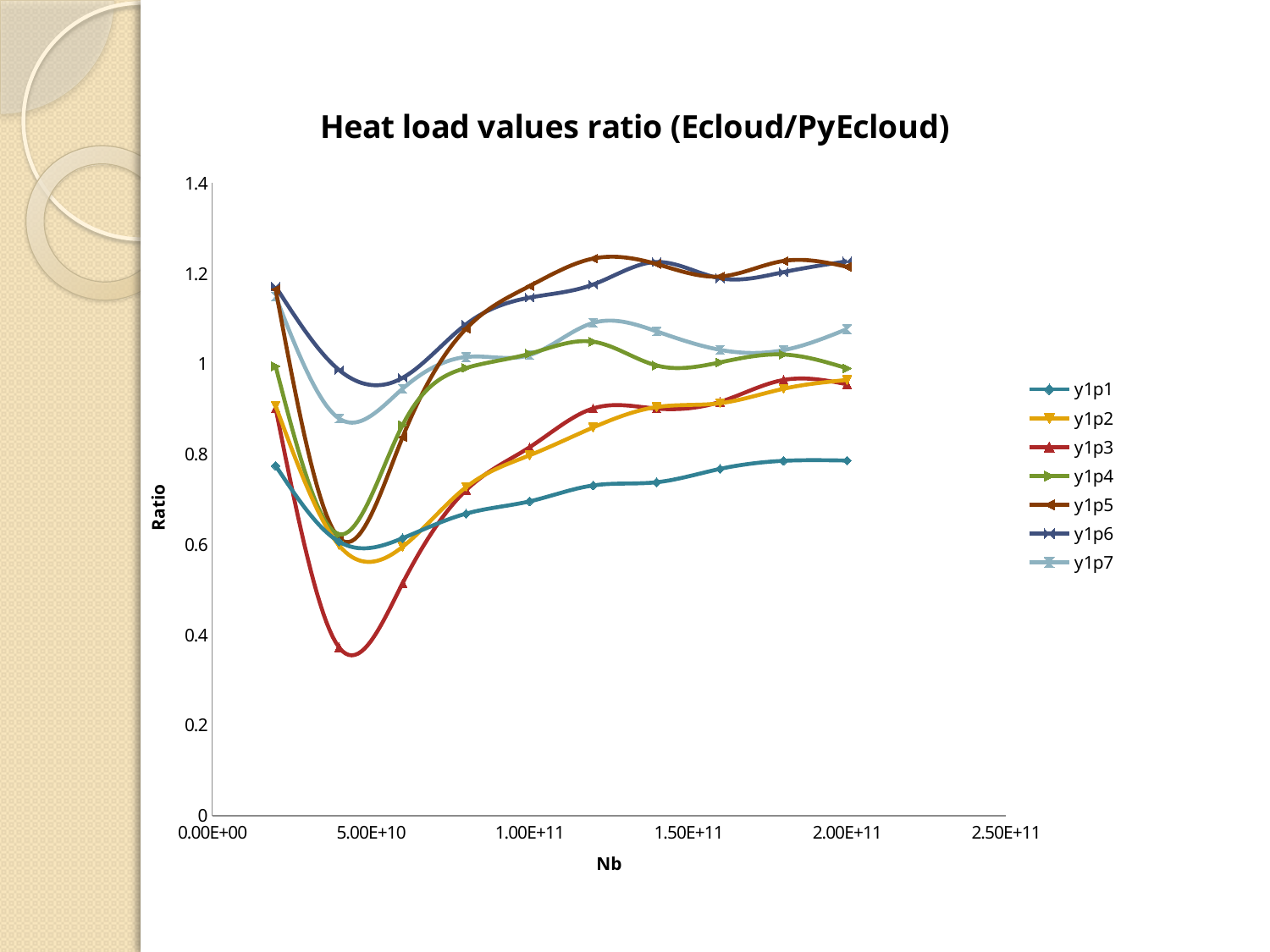
Which series has the highest value at Nb = 1.20E+11? y1p5 Which series has the lowest value at Nb = 2.00E+11? y1p1 Which series reaches the lowest value anywhere on the chart? y1p3 Is the value of y1p5 at Nb = 1.20E+11 greater or less than 1.2? greater What kind of chart is shown on the slide? line chart What is the title of the chart? Heat load values ratio (Ecloud/PyEcloud) Does the y1p1 series rise or fall between Nb = 6.00E+10 and Nb = 2.00E+11? rise What is the label of the vertical axis? Ratio At Nb = 2.00E+11, which series has the larger value, y1p1 or y1p3? y1p3 Is the value of y1p1 at Nb = 2.00E+11 greater or less than 1? less How many series does the legend list? 7 Is the value of y1p3 at Nb = 4.00E+10 greater or less than 0.6? less